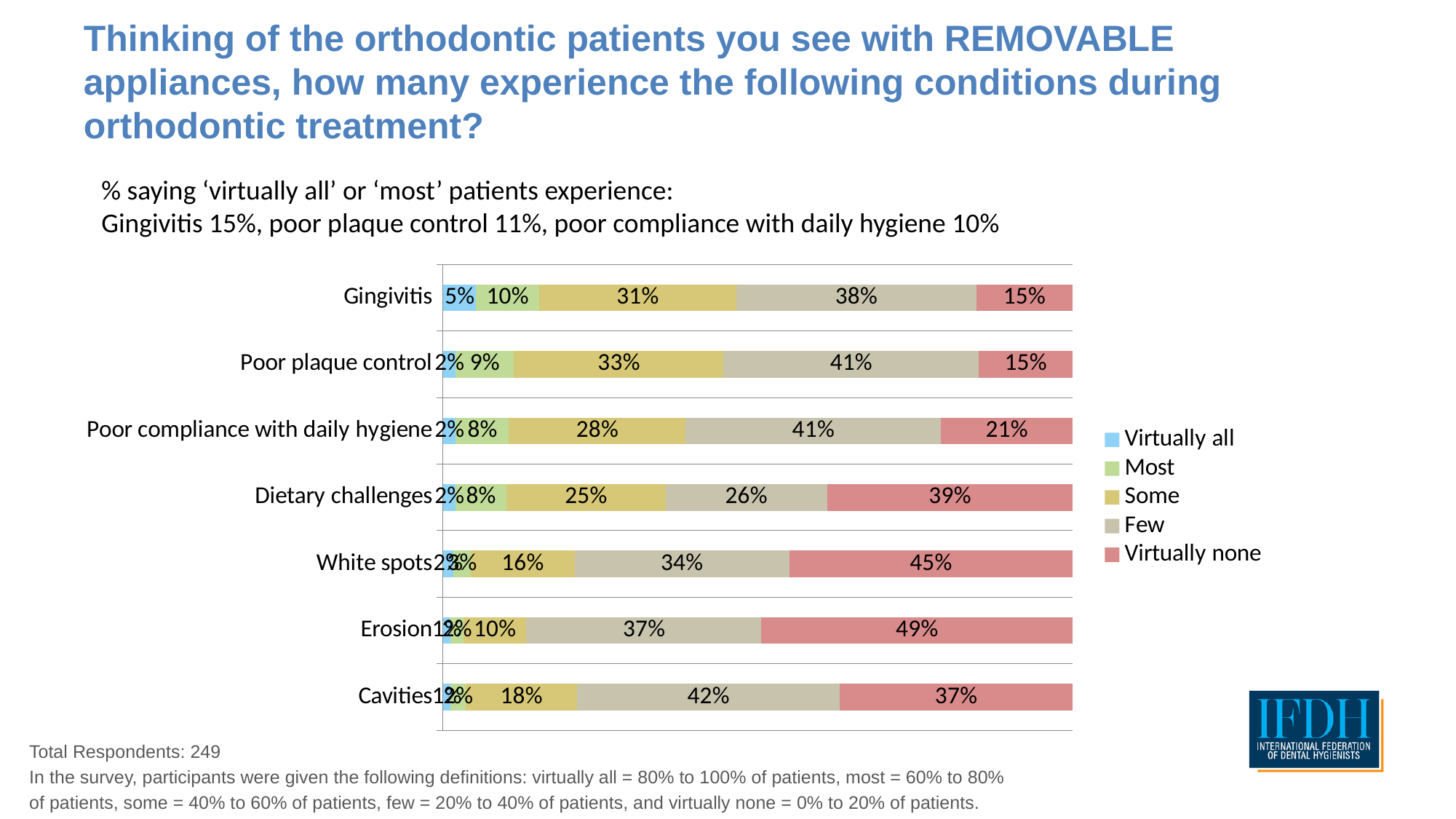
How many series does the legend list? 5 What is the 'Virtually none' value for Dietary challenges? 39% Which condition has the highest 'Some' percentage? Poor plaque control Which has a larger 'Virtually none' value, White spots or Cavities? White spots Which condition has the highest 'Virtually none' percentage? Erosion What percentage of respondents said 'Few' patients experience Gingivitis? 38% What is the 'Few' value for Cavities? 42% What is the difference between the 'Some' values for Poor plaque control and Gingivitis? 2 percentage points What are the legend entries of the chart, in order? Virtually all, Most, Some, Few, Virtually none How many conditions (categories) are plotted in the chart? 7 What kind of chart is shown on the slide? Stacked bar chart What is the 'Some' value for Poor compliance with daily hygiene? 28%